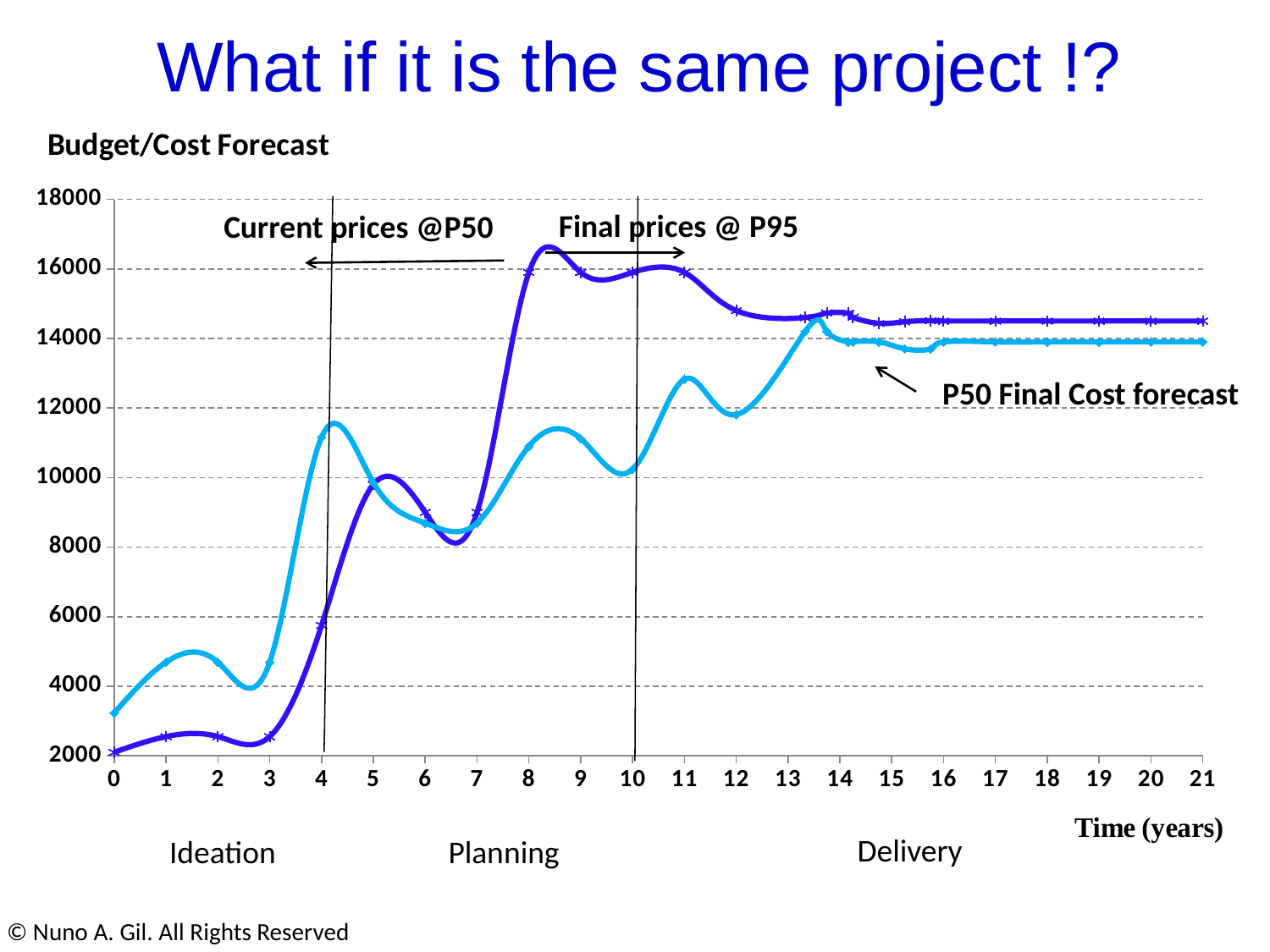
Is the value of the light blue line at year 4 greater or less than 10000? greater Overall, does the dark blue line rise or fall from year 0 to year 21? rise What is the label of the x axis? Time (years) What is the title of the chart? Budget/Cost Forecast Is the value of the dark blue line at year 8 greater or less than 14000? greater Is the value of the light blue line at year 3 greater or less than 6000? less What kind of chart is shown on the slide? line chart At year 4, which line has the higher value, the dark blue line or the light blue line? light blue line Which line reaches the highest value anywhere on the chart, the dark blue line or the light blue line? dark blue line At year 8, which line has the higher value, the dark blue line or the light blue line? dark blue line